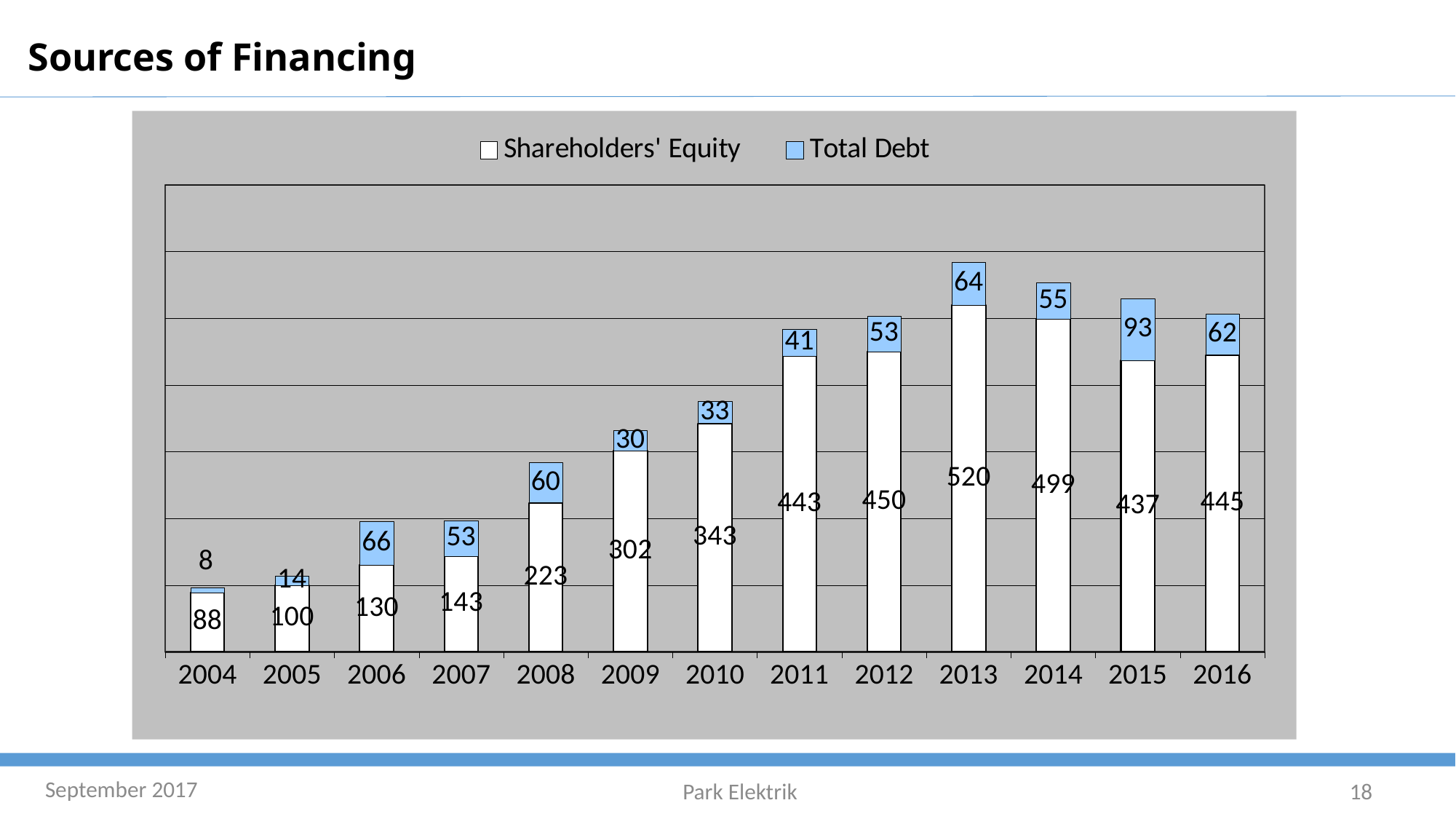
What is the title of the slide containing the chart? Sources of Financing What is the Shareholders' Equity value for 2013? 520 How many years are shown on the x axis? 13 What is the total of the stacked bar for 2013 (Shareholders' Equity plus Total Debt)? 584 Which is larger, Total Debt in 2006 or Total Debt in 2007? 2006 Which year has the lowest Total Debt? 2004 Which year has the highest Shareholders' Equity? 2013 What is the difference between Shareholders' Equity in 2013 and 2014? 21 What is the Shareholders' Equity value for 2008? 223 What is the Total Debt value for 2015? 93 How many series does the legend list? 2 What kind of chart is shown on the slide? Stacked bar chart